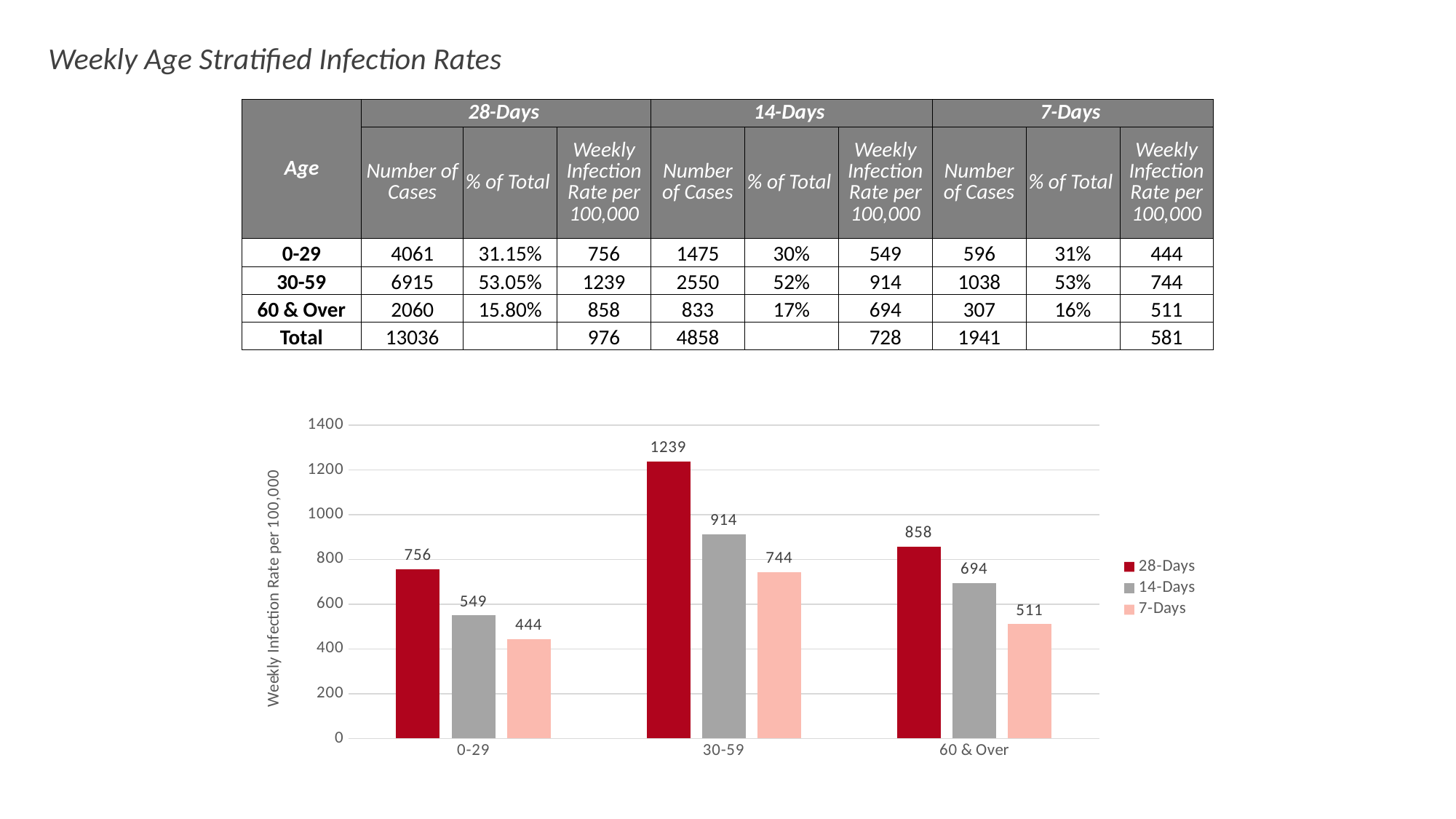
What is the 14-Days weekly infection rate per 100,000 for the 60 & Over age group in the chart? 694 What is the 7-Days weekly infection rate per 100,000 for the 0-29 age group in the chart? 444 Which age group has the highest 28-Days weekly infection rate in the chart? 30-59 Which age group has the lowest 7-Days weekly infection rate in the chart? 0-29 What is the 28-Days weekly infection rate per 100,000 for the 30-59 age group in the chart? 1239 How many series does the chart legend list? 3 What is the label of the vertical axis of the chart? Weekly Infection Rate per 100,000 What is the difference between the 28-Days and 7-Days weekly infection rates for the 60 & Over age group? 347 Which is larger in the chart: the 14-Days rate for 30-59 or the 28-Days rate for 60 & Over? 14-Days rate for 30-59 Is the 14-Days weekly infection rate for the 0-29 age group greater or less than 600? less What kind of chart is shown on the slide? bar chart How many age groups are shown on the x axis of the chart? 3